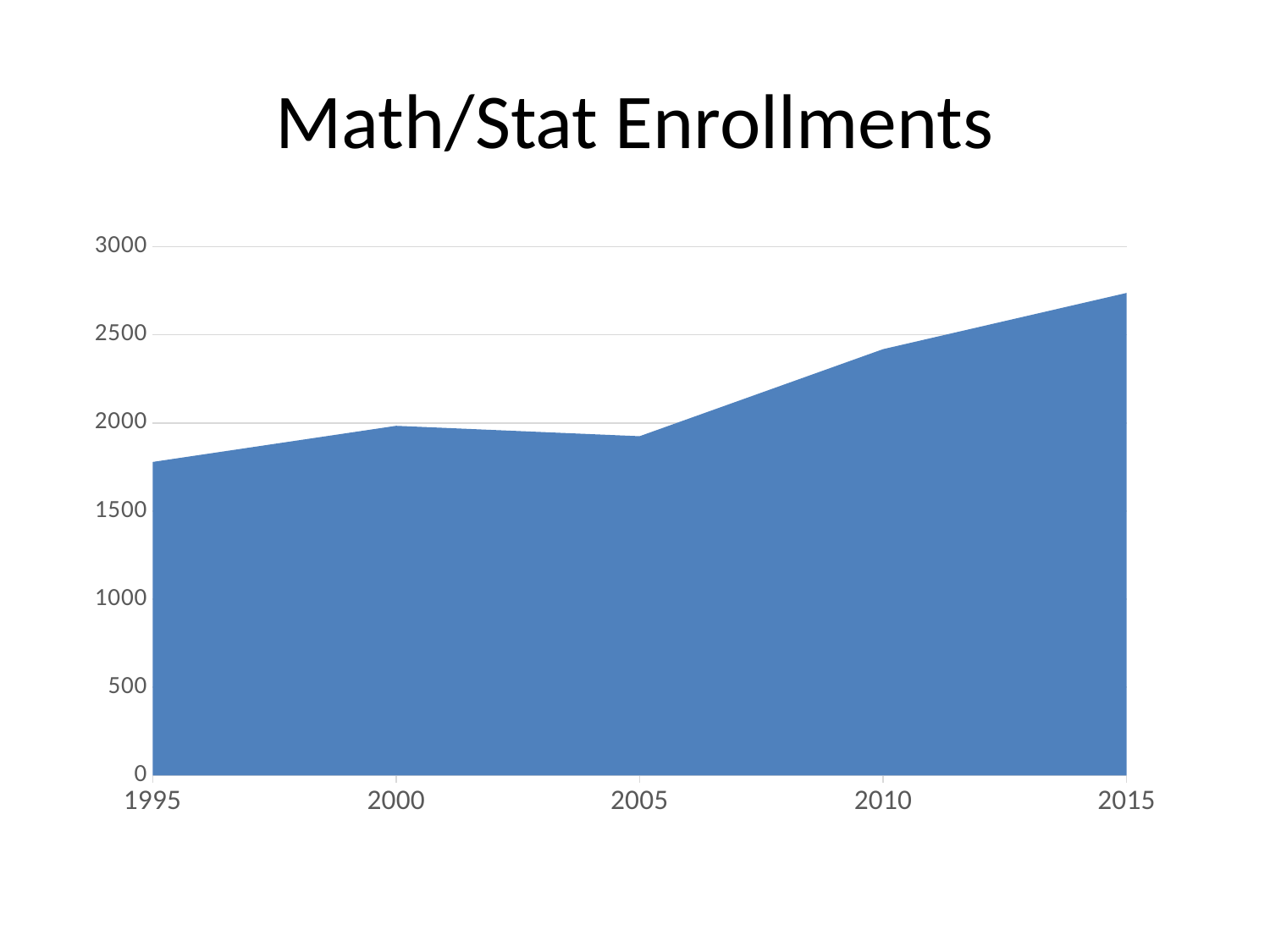
Which year has the larger enrollment, 1995 or 2000? 2000 Which year has the highest enrollment? 2015 What is the title of the chart? Math/Stat Enrollments How many years are plotted along the x axis? 5 Overall, do enrollments rise or fall from 1995 to 2015? Rise What type of chart is shown on the slide? Area chart Is the enrollment value for 2010 greater or less than 2000? greater Is the enrollment value for 2005 greater or less than 1500? greater Which year has the larger enrollment, 2010 or 2015? 2015 Is the enrollment value for 2015 greater or less than 2500? greater Which year has the lowest enrollment? 1995